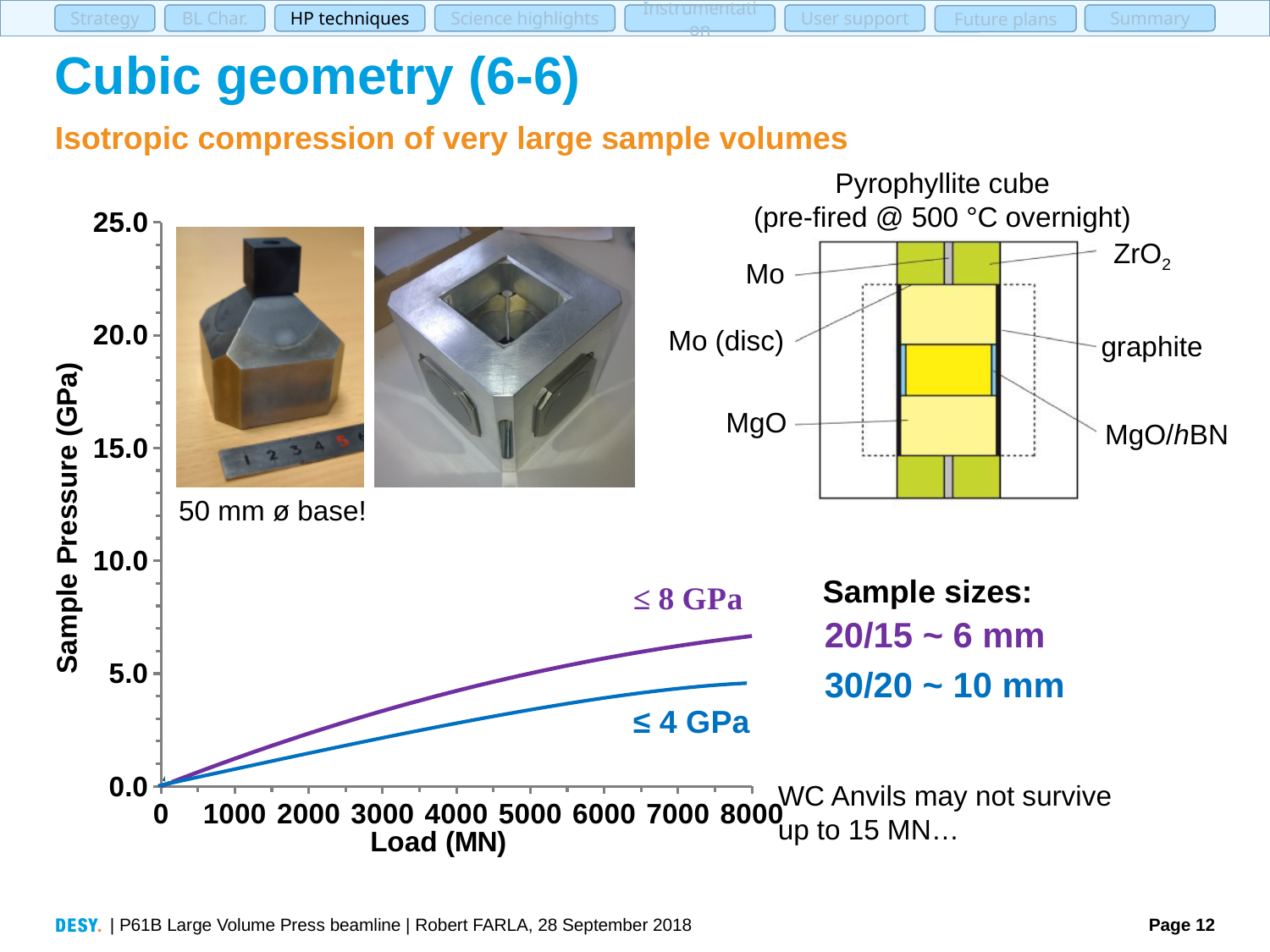
What is the maximum value shown on the y axis of the chart? 25.0 Is the sample pressure of the purple (≤ 8 GPa) curve at 8000 MN greater or less than 10.0 GPa? less What is the title of the x axis of the chart? Load (MN) Is the sample pressure of the purple (≤ 8 GPa) curve at 8000 MN greater or less than 5.0 GPa? greater Is the sample pressure of the blue (≤ 4 GPa) curve at 4000 MN greater or less than 5.0 GPa? less How many curves are plotted on the Sample Pressure vs Load chart? 2 What kind of chart is shown on the slide? line chart Which curve reaches the higher sample pressure at 8000 MN, the purple (≤ 8 GPa) curve or the blue (≤ 4 GPa) curve? the purple (≤ 8 GPa) curve How many labeled tick marks are there on the x axis of the chart? 9 What is the title of the y axis of the chart? Sample Pressure (GPa) Does the sample pressure rise or fall as the load increases along the x axis? rise